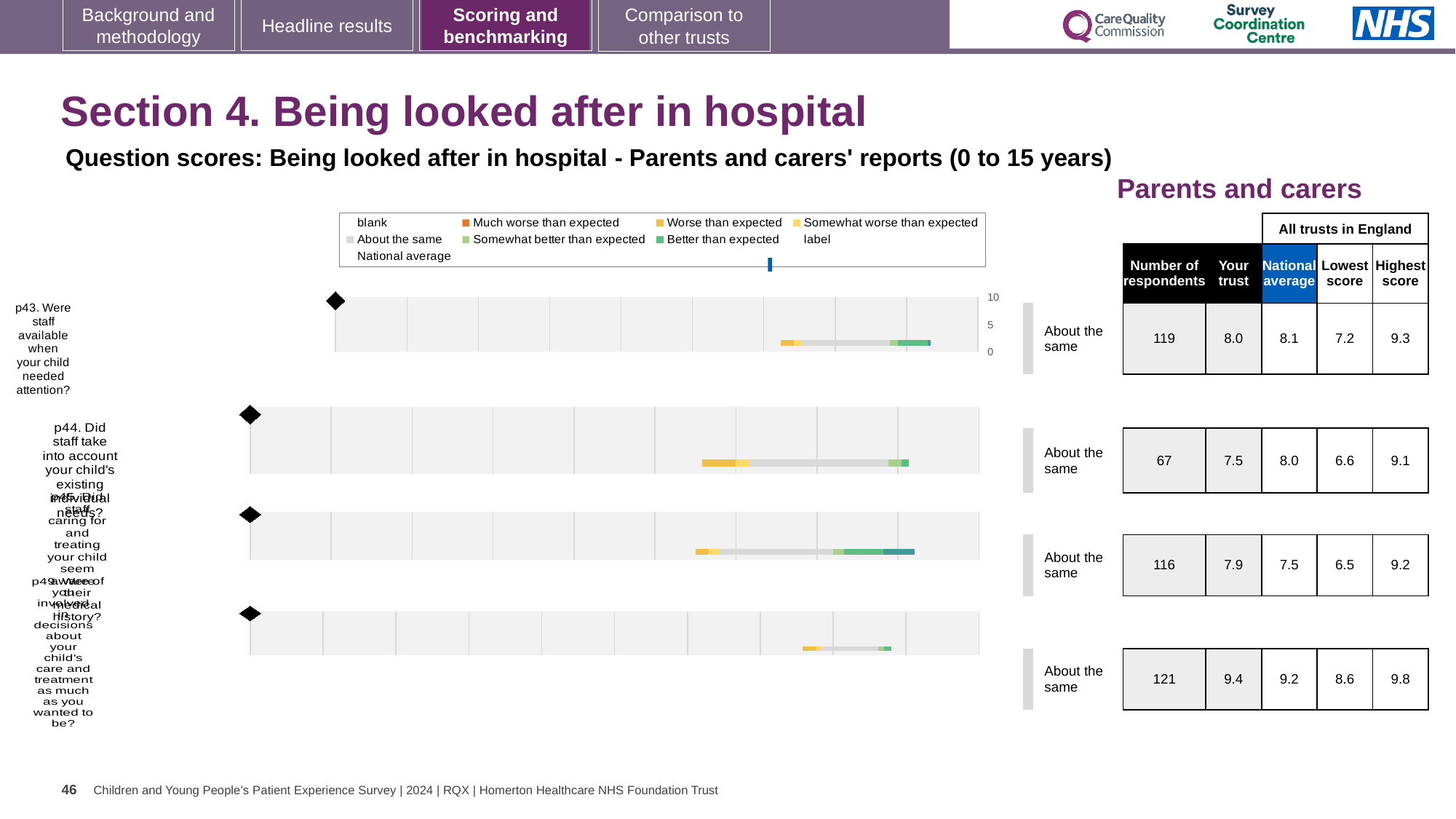
What kind of chart is used to show the question scores on this slide? Bar chart What is the national average score for p44? 8.0 Which question has the lowest number of respondents? p44 Which question has the highest 'Your trust' score? p49 What is the 'Your trust' score for p49? 9.4 What benchmark category is shown for p43? About the same For p45, which is larger: the 'Your trust' score or the national average? Your trust How many questions (bars) are plotted in the chart? 4 What colour does the legend use for 'Much worse than expected'? Orange What is the lowest score among all trusts in England for p49? 8.6 What is the number of respondents for p43 (Were staff available when your child needed attention?)? 119 For p43, what is the difference between the highest score and the lowest score among all trusts in England? 2.1